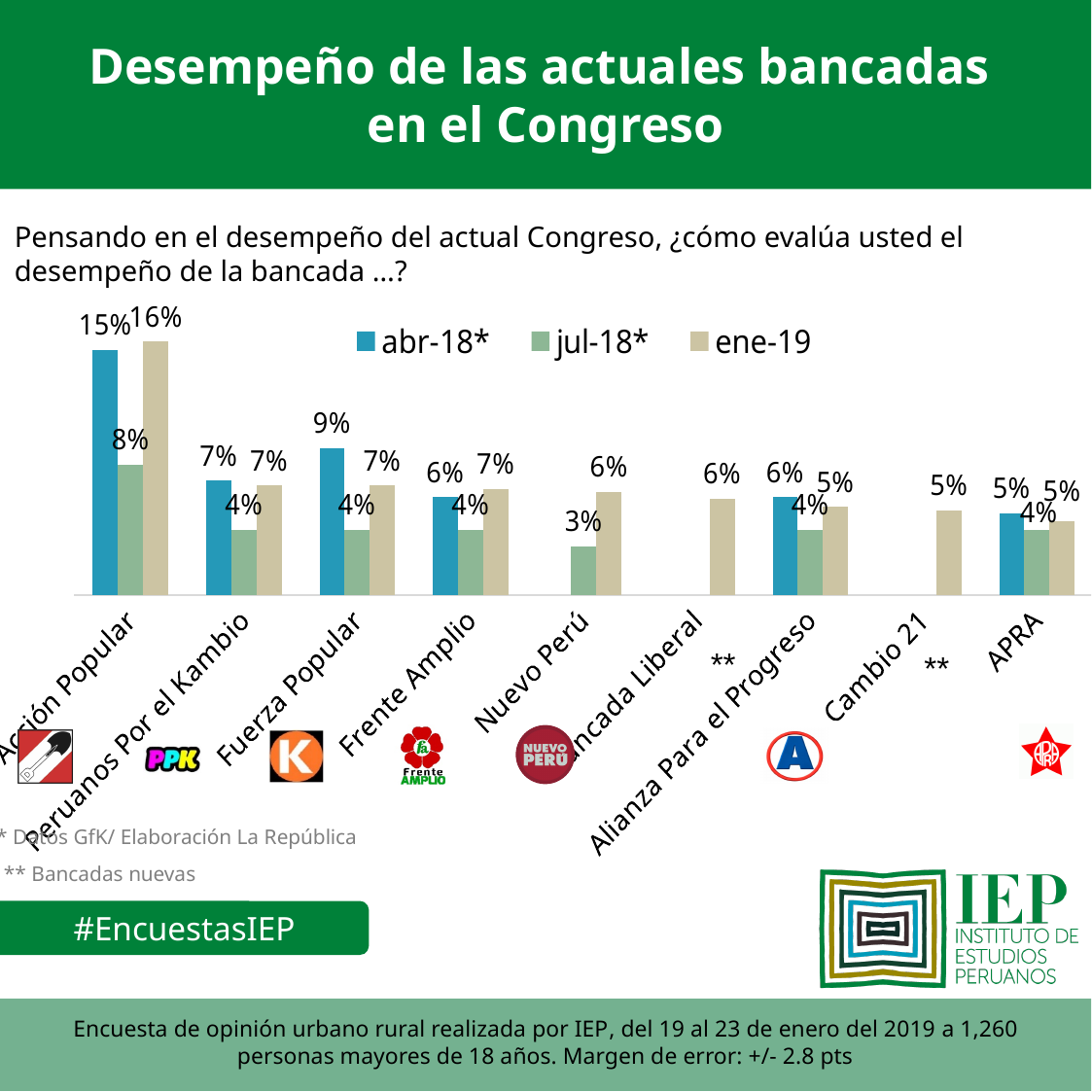
Which series is shown in blue in the legend? abr-18* What type of chart is shown on the slide? bar chart What is the difference between the abr-18 and jul-18 values for Acción Popular? 7% What is the abr-18 value for Fuerza Popular? 9% How many party groups (categories) are shown on the x axis? 9 Which party group has the lowest jul-18 value? Nuevo Perú How many series does the legend list? 3 Which party group has the highest ene-19 value? Acción Popular What is the ene-19 value for Bancada Liberal? 6% What is the ene-19 value for Acción Popular? 16% What is the jul-18 value for Nuevo Perú? 3% Which is larger for Fuerza Popular: the abr-18 value or the ene-19 value? abr-18